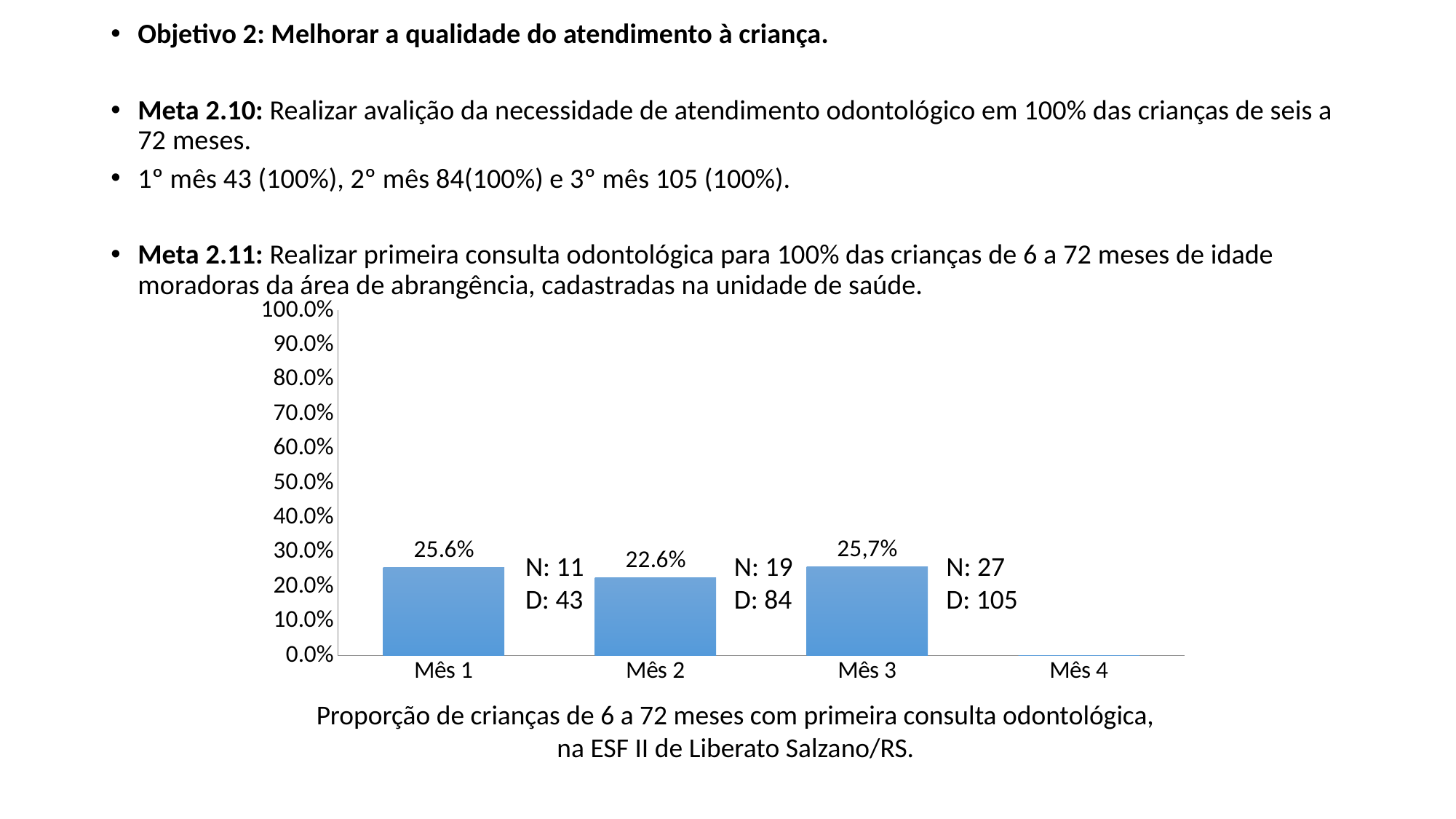
What is the value shown for Mês 1? 25.6% Is the value for Mês 2 greater or less than 30.0%? less What is the difference between the values for Mês 1 and Mês 2? 3.0% What is the numerator (N) shown next to the Mês 3 bar? 27 Does the value fall or rise from Mês 1 to Mês 2? fall Which is larger, the value for Mês 1 or the value for Mês 2? Mês 1 What is the value shown for Mês 3? 25,7% What is the denominator (D) shown next to the Mês 2 bar? 84 Which of the three months with bars has the lowest value? Mês 2 How many month categories are shown on the x axis? 4 What kind of chart is shown on the slide? bar chart What is the value shown for Mês 2? 22.6%